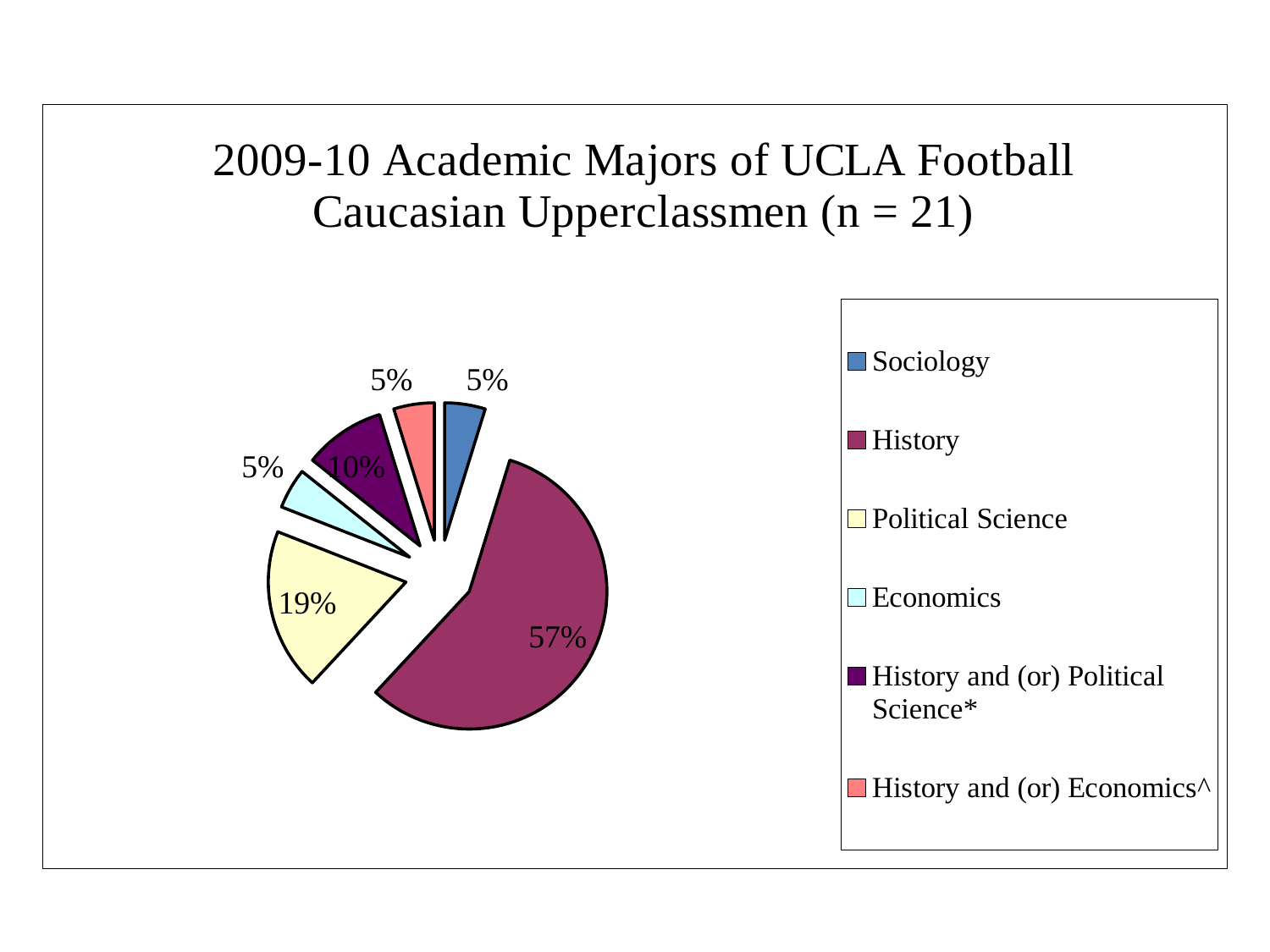
How many slices does the pie chart have? 6 How many entries does the legend list? 6 What is the difference in percentage points between the History slice and the Political Science slice? 38 What type of chart is shown on the slide? pie chart Which major has the largest slice of the pie? History What share of the pie does Political Science represent? 19% What share of the pie does History represent? 57% What share of the pie does Economics represent? 5% Which is larger, the Political Science slice or the History and (or) Political Science* slice? Political Science What is the title of the chart? 2009-10 Academic Majors of UCLA Football Caucasian Upperclassmen (n = 21)